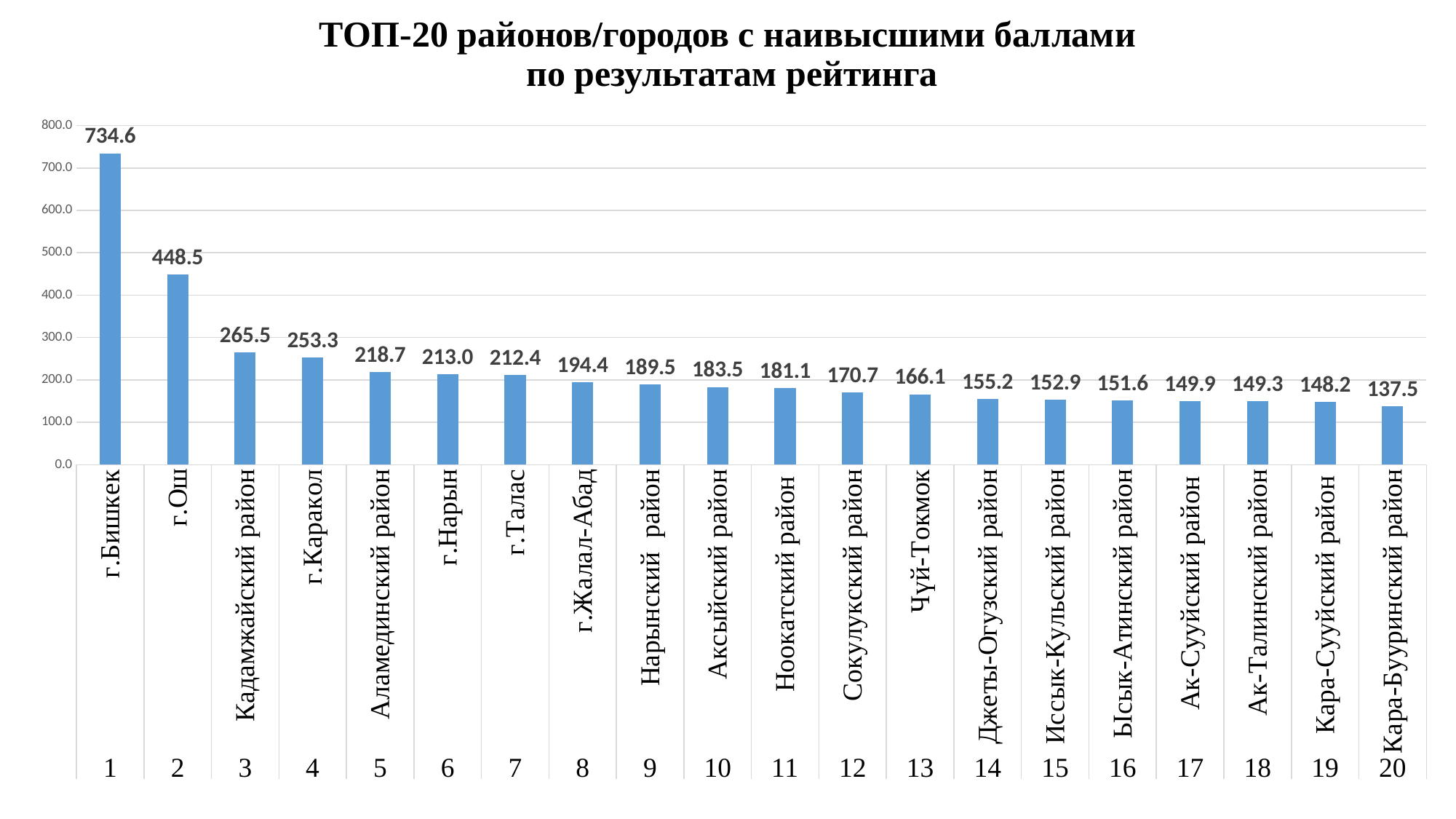
Which category has the highest value? г.Бишкек What kind of chart is this? bar chart Which is larger, the value for г.Каракол or the value for Аламединский район? г.Каракол Which category has the lowest value? Кара-Бууринский район How many categories are shown in the chart? 20 What is the value for Чуй-Токмок? 166.1 What is the difference between the values for г.Бишкек and г.Ош? 286.1 What is the value for г.Талас? 212.4 What is the value for Кадамжайский район? 265.5 What is the value for г.Бишкек? 734.6 Do the values rise or fall from left to right along the x axis? fall What is the title of the chart? ТОП-20 районов/городов с наивысшими баллами по результатам рейтинга